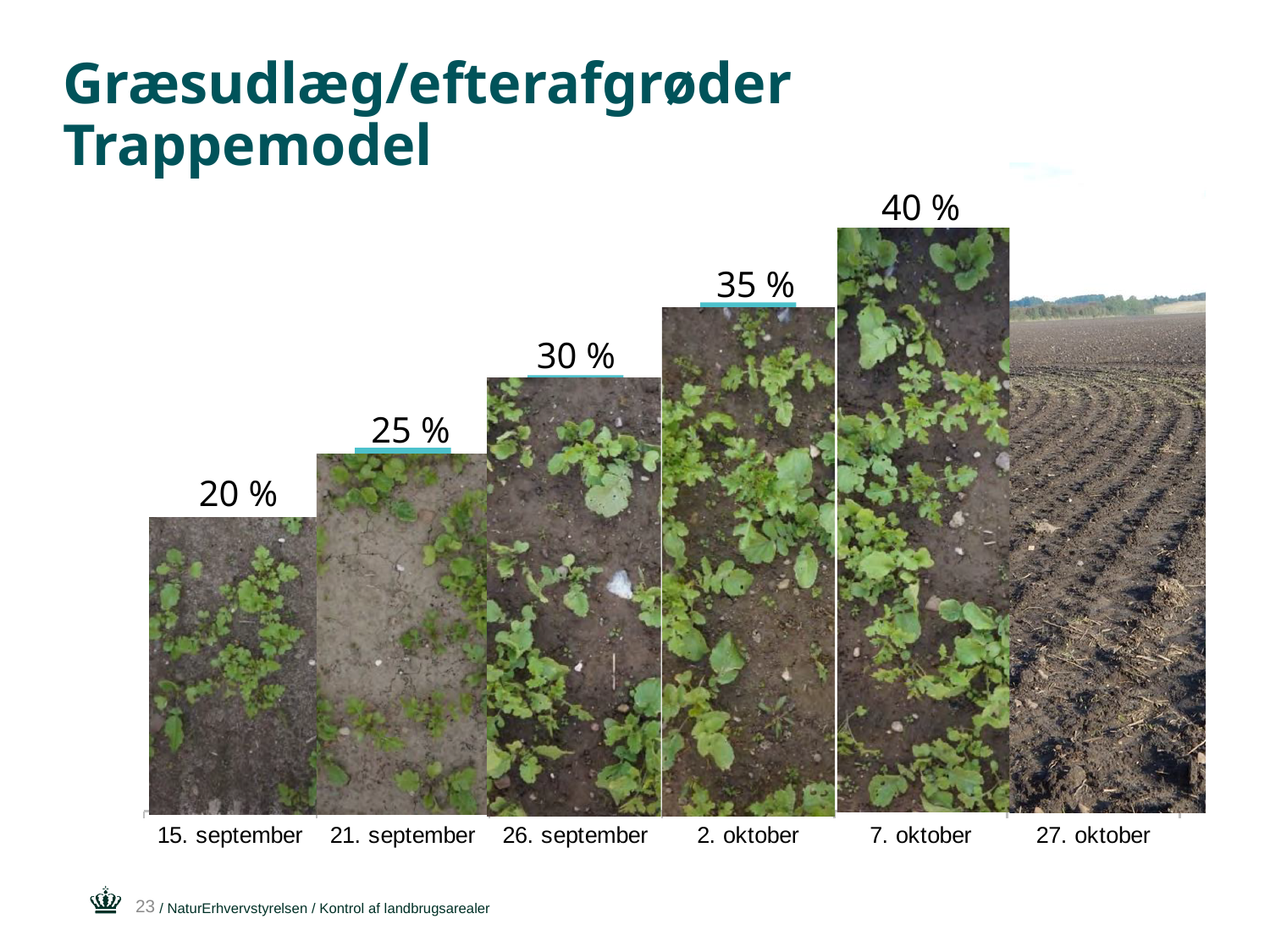
What value is shown for 26. september? 30 % Which is larger, the value for 2. oktober or the value for 21. september? 2. oktober What value is shown for 7. oktober? 40 % What value is shown for 15. september? 20 % Which date has the tallest bar? 7. oktober What value is shown for 2. oktober? 35 % What is the difference between the values for 7. oktober and 15. september? 20 % Which date has the lowest bar? 15. september Do the bars rise or fall from 15. september to 27. oktober? rise How many dates are shown along the x axis? 6 What value is shown for 21. september? 25 % What kind of chart is this? bar chart